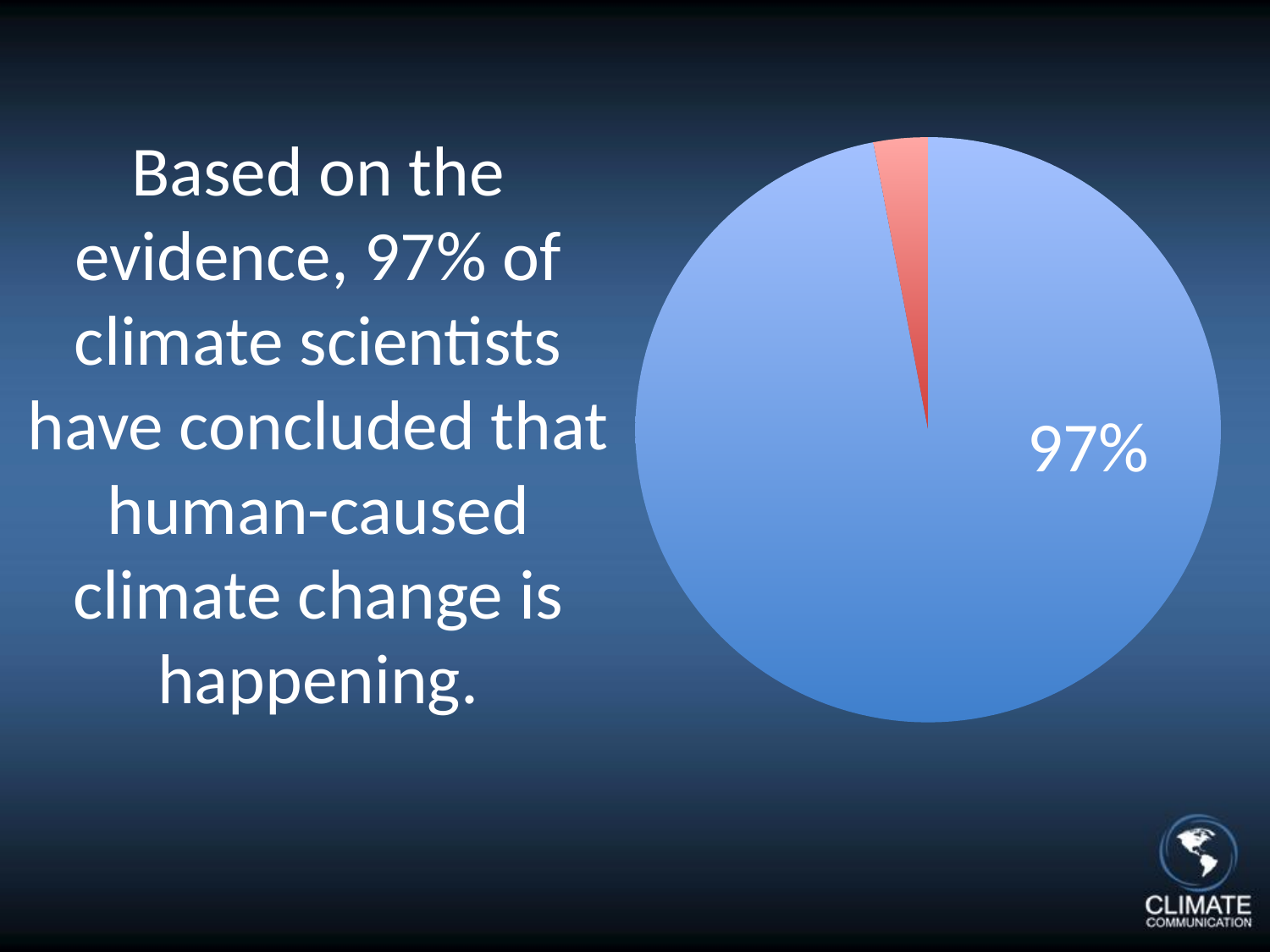
What share of the pie does the blue slice represent? 97% How many slices does the pie chart have? 2 What percentage is printed on the large blue slice of the pie chart? 97% What kind of chart is shown on the slide? pie chart Is the blue slice or the red slice larger in the pie chart? the blue slice Is the share of the blue slice greater or less than 50%? greater Which slice of the pie chart is the largest, the blue one or the red one? the blue one Does the pie chart display a legend? No Which slice of the pie chart is the smallest? the red slice What colour is the slice labelled 97%? blue